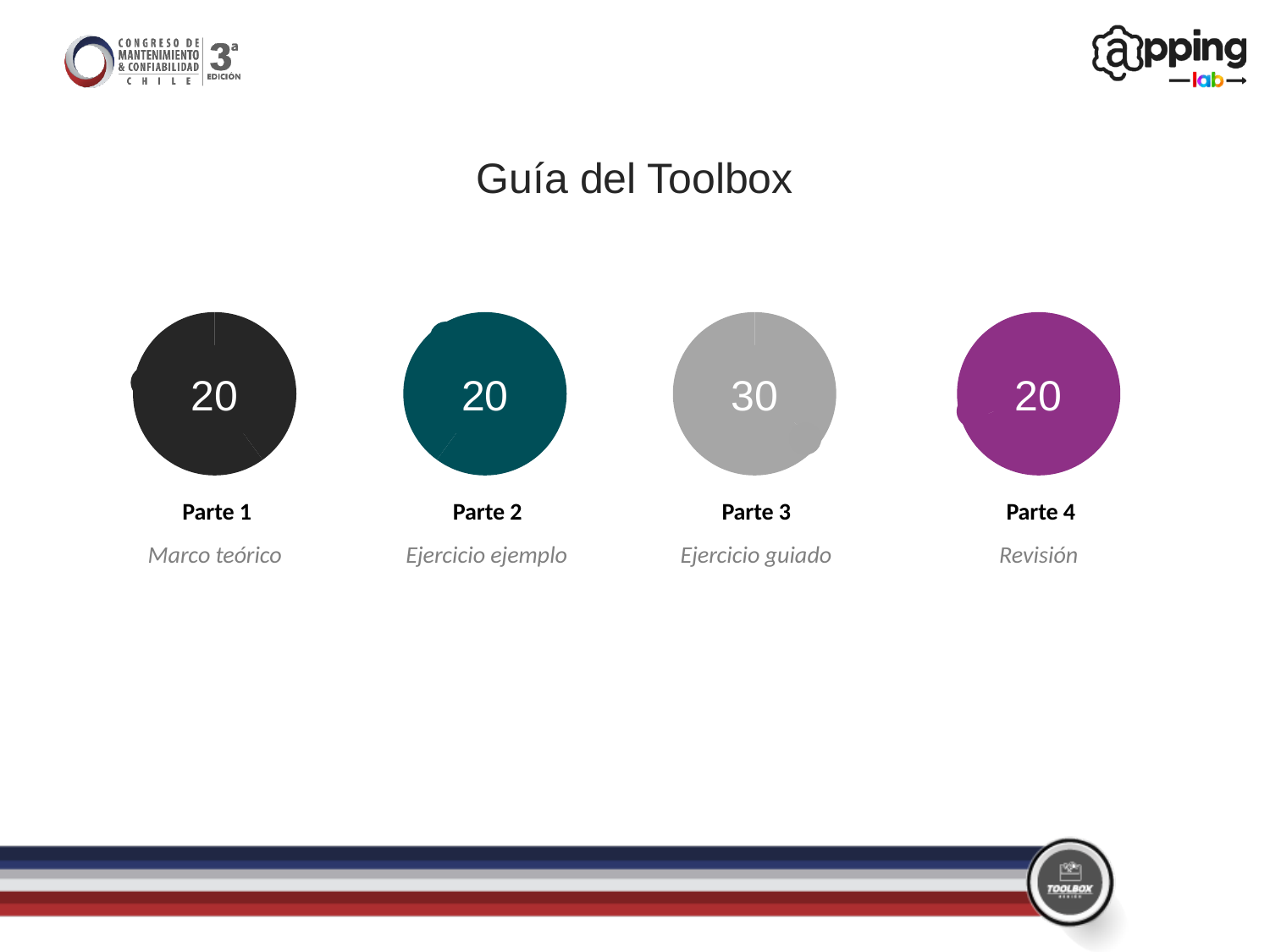
What is the total of the four values shown in the circles? 90 What value is shown in the circle for Parte 2 (Ejercicio ejemplo)? 20 What is the title of the slide containing the charts? Guía del Toolbox What kind of chart is used for each part on the slide? Doughnut chart What value is shown in the circle for Parte 3 (Ejercicio guiado)? 30 How many circular charts are shown on the slide? 4 Which part has the highest value shown in its circle? Parte 3 What is the difference between the value for Parte 3 and the value for Parte 1? 10 What value is shown in the circle for Parte 1? 20 Which is larger, the value for Parte 3 or the value for Parte 4? Parte 3 What is the subtitle under Parte 3? Ejercicio guiado What value is shown in the circle for Parte 4 (Revisión)? 20